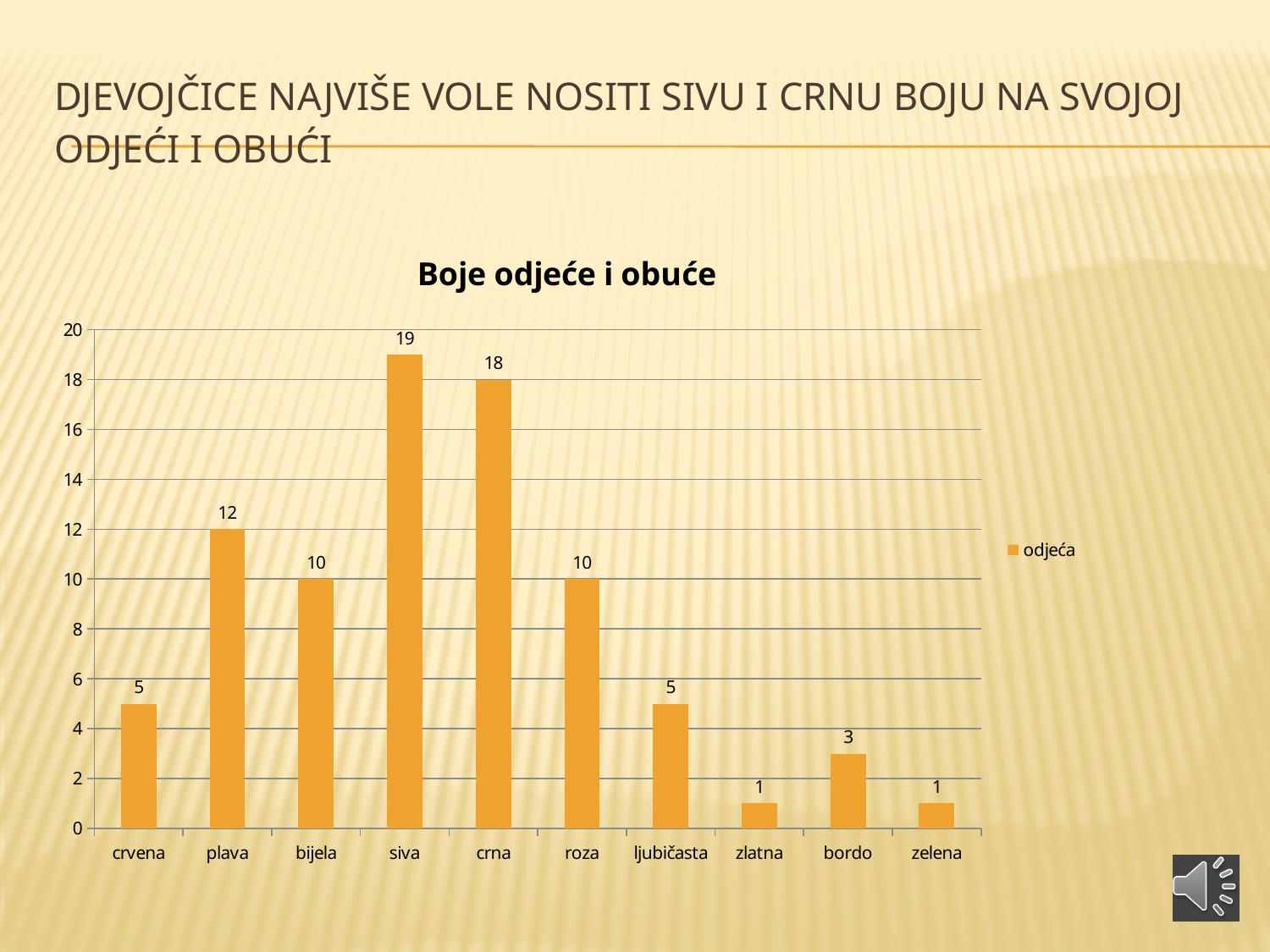
What is the difference between the values for plava and ljubičasta? 7 How many series does the legend list? 1 Which is larger, the value for crvena or the value for bijela? bijela What is the difference between the values for siva and crna? 1 How many categories are shown on the x axis? 10 What is the value for bordo? 3 What is the value for siva? 19 What is the value for plava? 12 Is the value for crna greater or less than 10? greater Which category has the highest value? siva What is the title of the chart? Boje odjeće i obuće What kind of chart is shown? bar chart